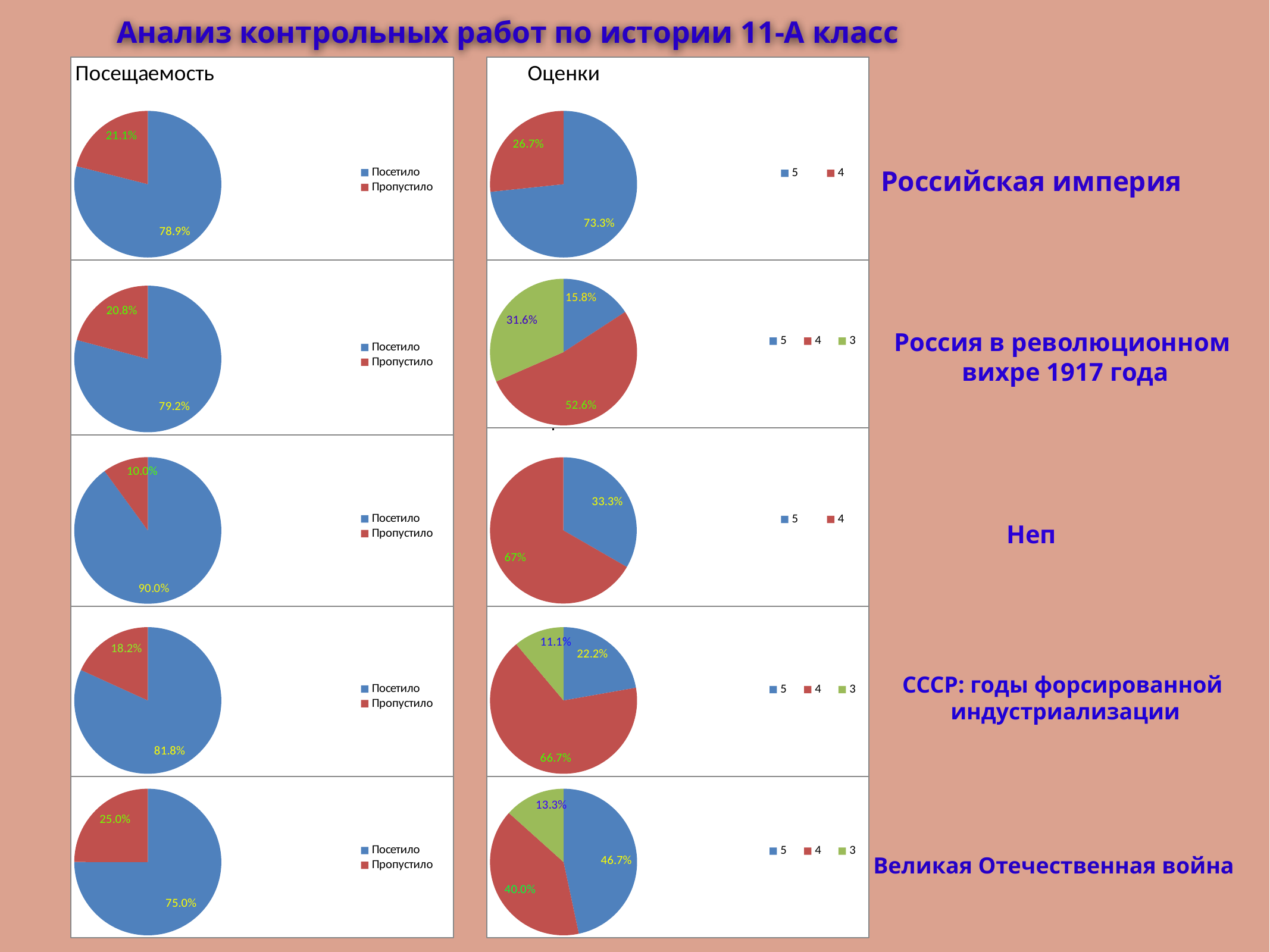
In the Посещаемость pie chart for the Неп row, what percentage is shown for Посетило? 90.0% In the Оценки pie chart for the СССР: годы форсированной индустриализации row, which grade has the smallest slice? 3 In the Оценки pie chart for the Неп row, what is the difference between the grade 4 share and the grade 5 share? 33.4% In the Оценки pie chart for the Великая Отечественная война row, which is larger: the share for grade 5 or the share for grade 4? 5 In the Оценки pie chart for the Великая Отечественная война row, what percentage is shown for grade 4? 40.0% In the Посещаемость pie chart for the Великая Отечественная война row, what percentage is shown for Пропустило? 25.0% How many legend entries does the Оценки pie chart for the СССР: годы форсированной индустриализации row list? 3 In the Оценки pie chart for the Россия в революционном вихре 1917 года row, what percentage is shown for grade 3? 31.6% In the Оценки pie chart for the Россия в революционном вихре 1917 года row, which grade has the largest slice? 4 In the Посещаемость pie chart for the Российская империя row, what share is labelled for Пропустило? 21.1% What type of chart is used in the Посещаемость column? Pie chart In the Оценки pie chart for the Российская империя row, what percentage is shown for grade 5? 73.3%